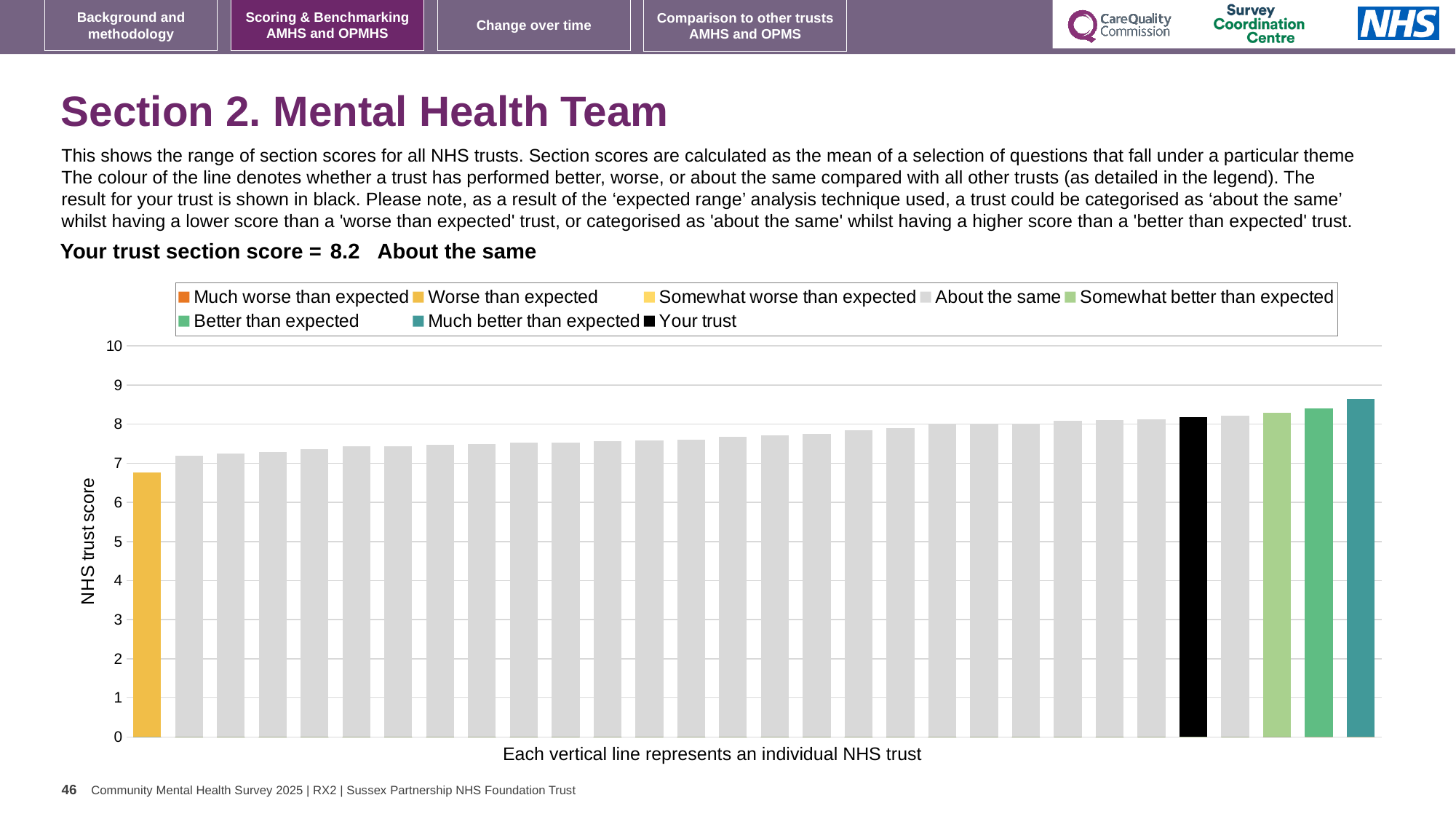
What colour is the bar representing your trust? black Is the value of the rightmost bar greater or less than 9? less Do the bar values rise or fall from left to right along the x axis? rise Which category is your trust placed in for this section? About the same How many entries does the chart legend list? 8 Which legend category does the highest bar belong to? Much better than expected Is the value of the rightmost bar greater or less than 8? greater Is the value of the leftmost (yellow) bar greater or less than 7? less What is the section score for your trust shown on the slide? 8.2 Which legend category does the lowest bar belong to? Worse than expected Which is larger: the bar for your trust or the leftmost yellow bar? your trust What kind of chart is shown on the slide? bar chart